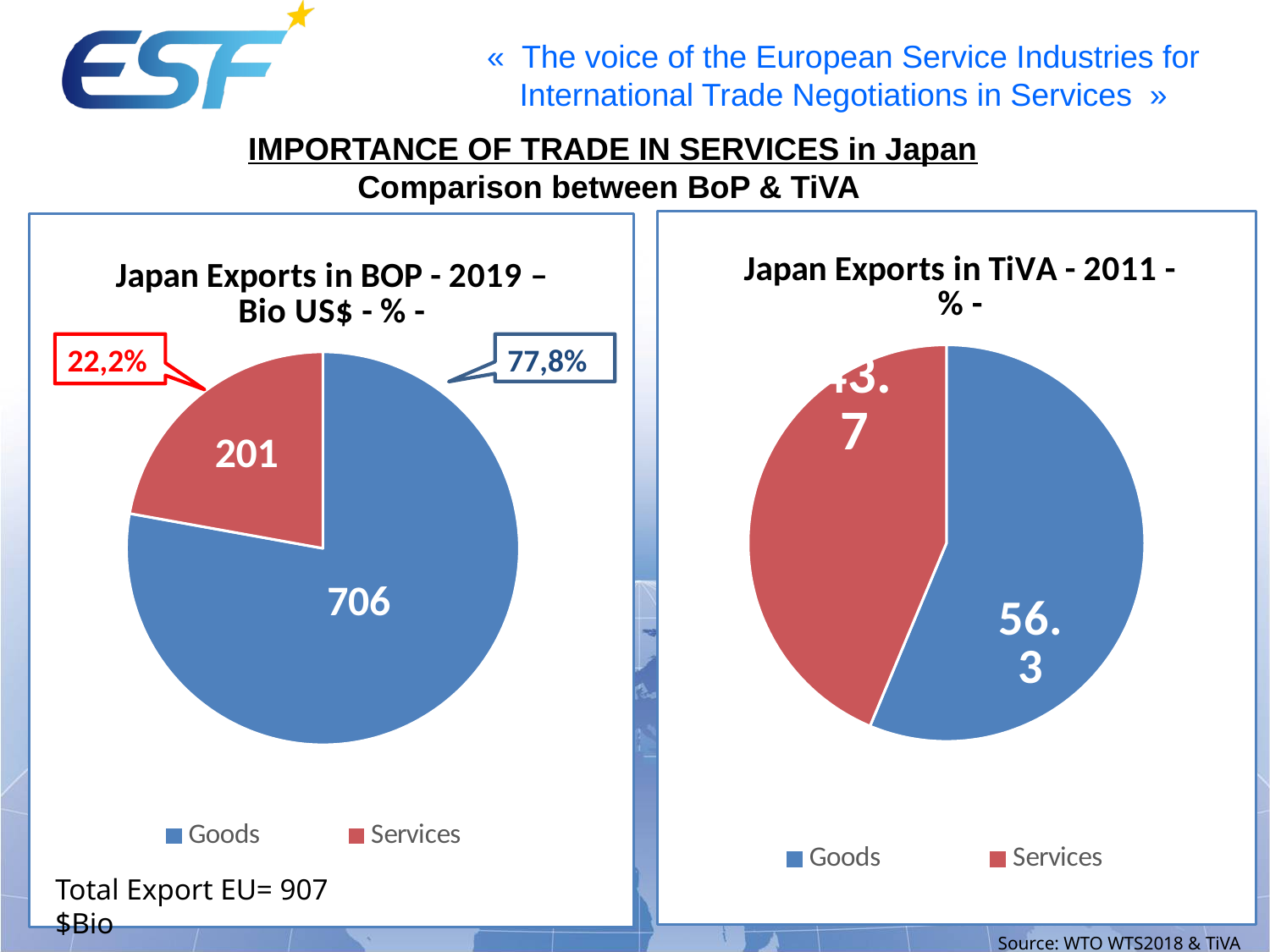
In the 'Japan Exports in BOP - 2019' chart, which category is the largest? Goods What type of chart is the 'Japan Exports in TiVA - 2011' chart? Pie chart In the 'Japan Exports in TiVA - 2011' chart, which is larger, Goods or Services? Goods In the 'Japan Exports in BOP - 2019' chart, what is the value for Services? 201 In the 'Japan Exports in TiVA - 2011' chart, which category is the smallest? Services In the 'Japan Exports in BOP - 2019' chart, what is the difference between the Goods and Services values? 505 In the 'Japan Exports in BOP - 2019' chart, what percentage share does Goods have? 77,8% How many entries does the legend of the 'Japan Exports in BOP - 2019' chart list? 2 In the 'Japan Exports in BOP - 2019' chart, what is the value for Goods? 706 In the 'Japan Exports in BOP - 2019' chart, what is the total of the Goods and Services values? 907 In the 'Japan Exports in TiVA - 2011' chart, what is the value for Goods? 56.3 In the 'Japan Exports in BOP - 2019' chart, what percentage share does Services have? 22,2%